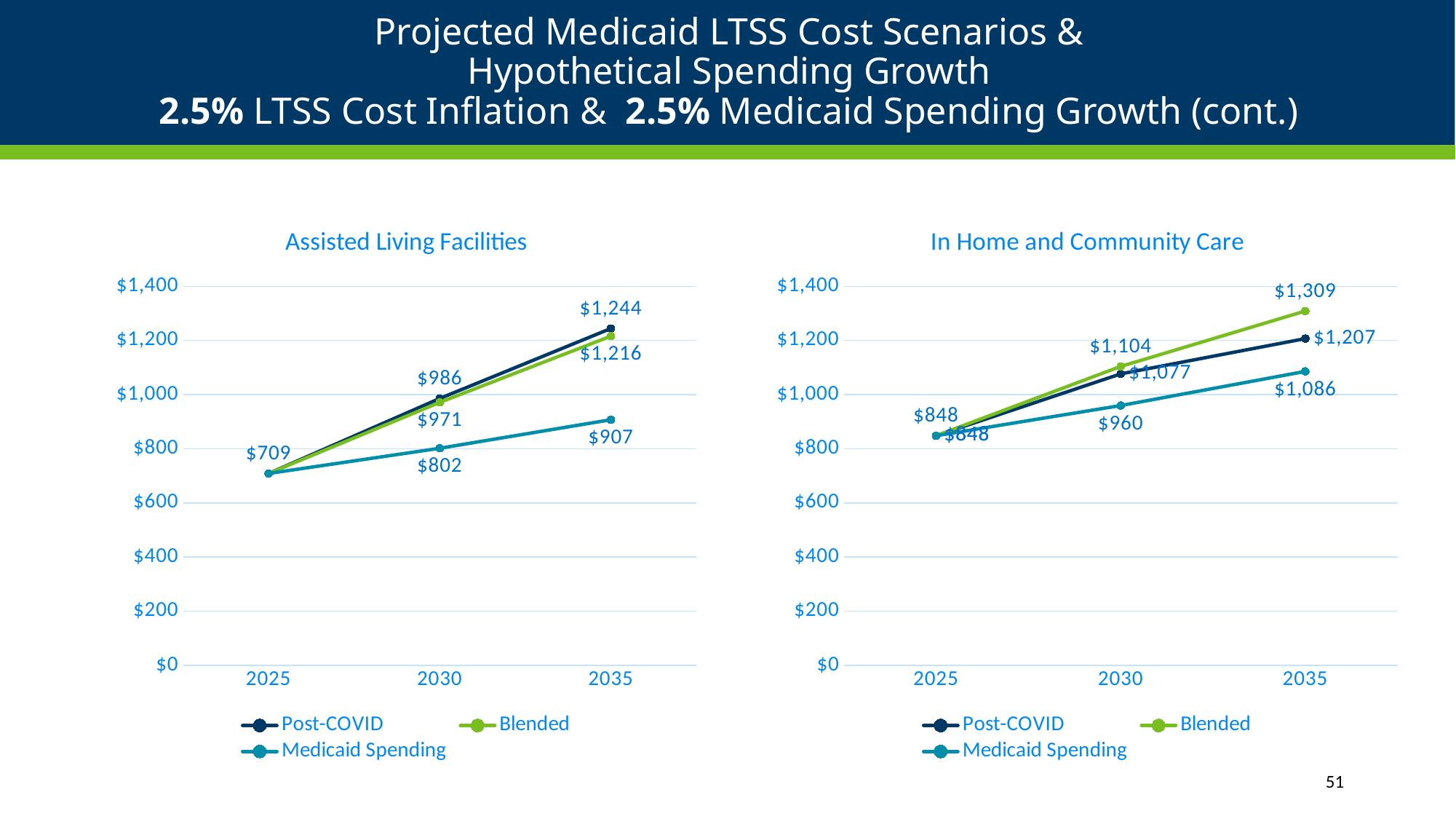
In the Assisted Living Facilities chart, what is the Medicaid Spending value for 2030? $802 In the Assisted Living Facilities chart, what is the difference between the Post-COVID and Medicaid Spending values in 2035? $337 In the Assisted Living Facilities chart, which series has the highest value in 2035? Post-COVID In the In Home and Community Care chart, which series has the lowest value in 2035? Medicaid Spending In the Assisted Living Facilities chart, what is the Post-COVID value for 2035? $1,244 In the Assisted Living Facilities chart, does the Medicaid Spending series rise or fall from 2025 to 2035? Rise How many series does the legend of the Assisted Living Facilities chart list? 3 In the In Home and Community Care chart, which is larger in 2030: the Blended value or the Post-COVID value? Blended In the In Home and Community Care chart, what is the Blended value for 2035? $1,309 In the In Home and Community Care chart, what is the Medicaid Spending value for 2030? $960 In the In Home and Community Care chart, what is the difference between the Blended and Post-COVID values in 2035? $102 What kind of chart is the In Home and Community Care chart? Line chart